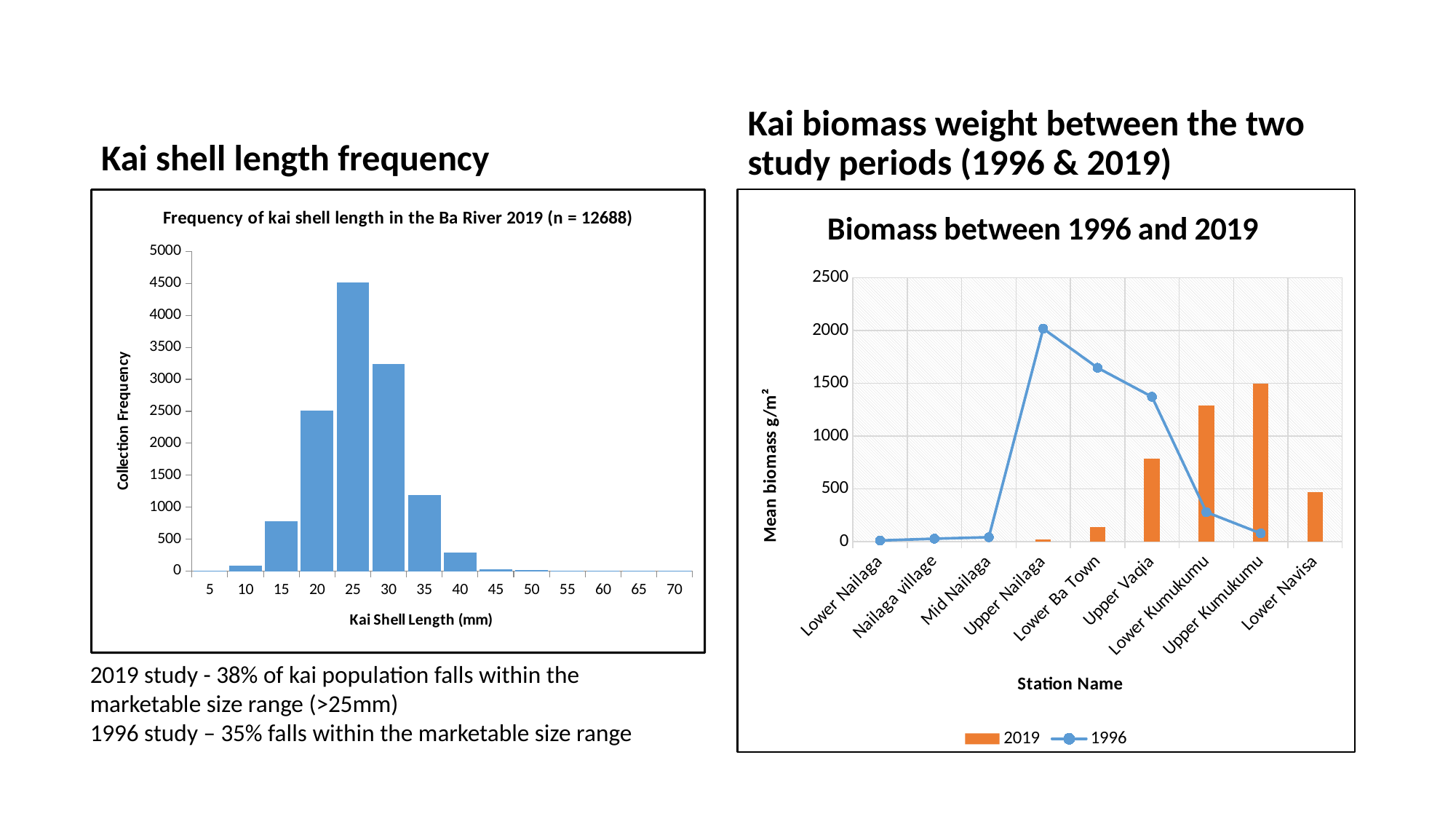
In the right chart (Biomass between 1996 and 2019), which station has the highest 1996 mean biomass? Upper Nailaga In the right chart (Biomass between 1996 and 2019), at Upper Vaqia, which series has the larger mean biomass, 1996 or 2019? 1996 In the left chart (Frequency of kai shell length in the Ba River 2019), which has the higher collection frequency, 20 mm or 35 mm? 20 mm In the left chart (Frequency of kai shell length in the Ba River 2019), is the collection frequency for 15 mm greater or less than 1000? less In the left chart (Frequency of kai shell length in the Ba River 2019), is the collection frequency for 25 mm greater or less than 4000? greater In the left chart (Frequency of kai shell length in the Ba River 2019), is the collection frequency for 30 mm greater or less than 3000? greater In the left chart (Frequency of kai shell length in the Ba River 2019), which shell length has the highest collection frequency? 25 In the right chart (Biomass between 1996 and 2019), how many stations are shown on the x axis? 9 What kind of chart is the left chart (Frequency of kai shell length in the Ba River 2019)? Bar chart In the left chart (Frequency of kai shell length in the Ba River 2019), how many shell length categories are shown on the x axis? 14 In the right chart (Biomass between 1996 and 2019), how many series does the legend list? 2 In the right chart (Biomass between 1996 and 2019), which station has the highest 2019 mean biomass? Upper Kumukumu